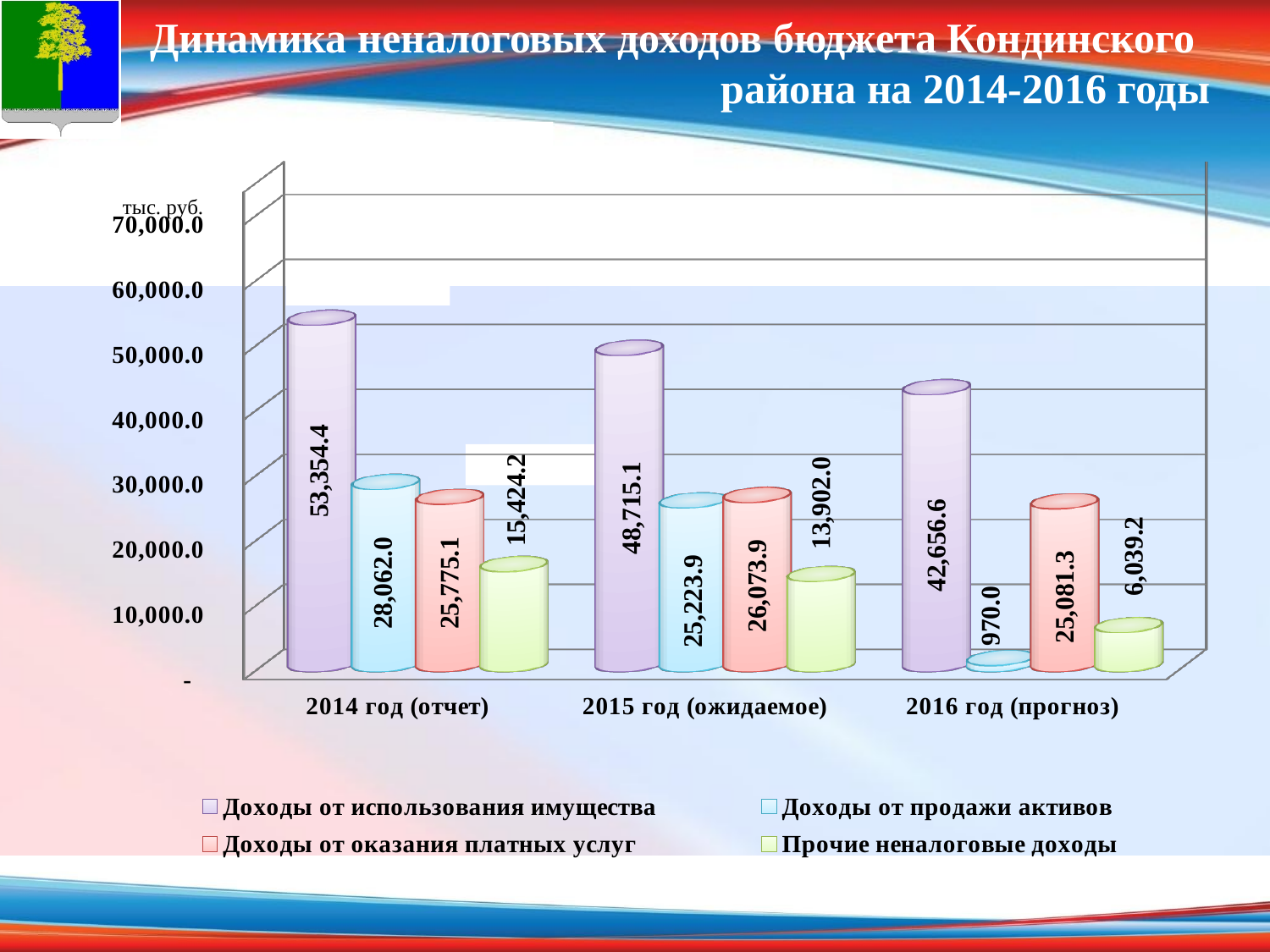
How many year categories are shown on the x axis? 3 What is the value for Доходы от использования имущества in 2014 год (отчет)? 53,354.4 In which year is the value for Прочие неналоговые доходы the lowest? 2016 год (прогноз) What is the value for Доходы от оказания платных услуг in 2016 год (прогноз)? 25,081.3 Is the value for Доходы от использования имущества in 2016 год (прогноз) greater or less than 40,000.0? greater Does the value for Доходы от использования имущества rise or fall from 2014 to 2016? fall What is the value for Доходы от продажи активов in 2016 год (прогноз)? 970.0 In which year is the value for Доходы от использования имущества the highest? 2014 год (отчет) What is the value for Прочие неналоговые доходы in 2015 год (ожидаемое)? 13,902.0 What is the difference between the Доходы от использования имущества values for 2014 год (отчет) and 2015 год (ожидаемое)? 4,639.3 How many series does the legend list? 4 Which is larger in 2015 год (ожидаемое): Доходы от продажи активов or Доходы от оказания платных услуг? Доходы от оказания платных услуг